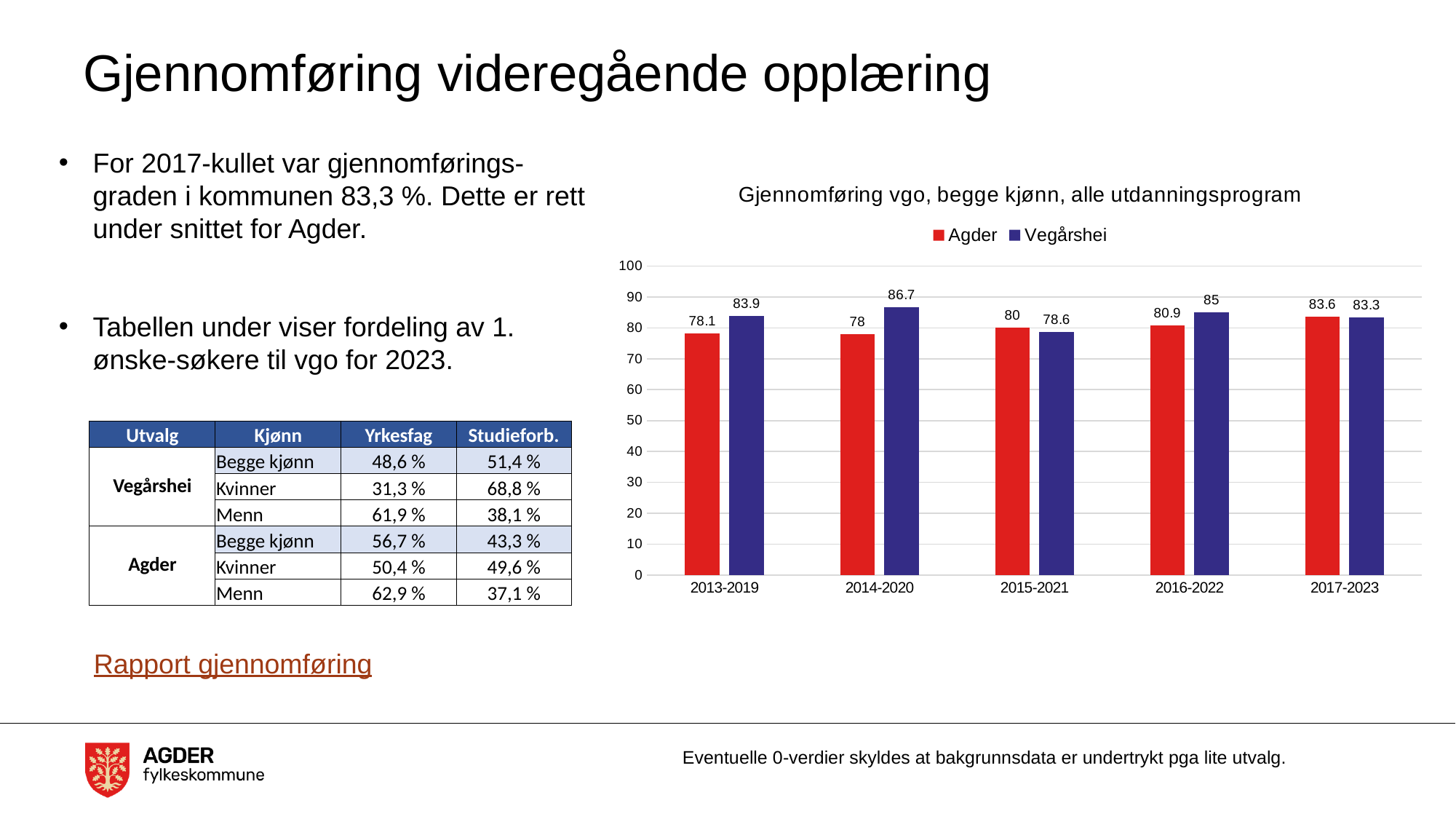
What is the value for Agder in 2013-2019? 78.1 Is the value for Vegårshei in 2016-2022 greater or less than 80? greater Which period has the highest value for Vegårshei? 2014-2020 What is the value for Vegårshei in 2017-2023? 83.3 What kind of chart is shown on the slide? Bar chart What is the value for Vegårshei in 2014-2020? 86.7 Do the Agder values rise or fall from 2013-2019 to 2017-2023? Rise What is the difference between the Vegårshei and Agder values in 2014-2020? 8.7 How many periods are shown on the x axis? 5 How many series does the legend list? 2 In 2015-2021, which is larger, the Agder value or the Vegårshei value? Agder Which period has the lowest value for Agder? 2014-2020